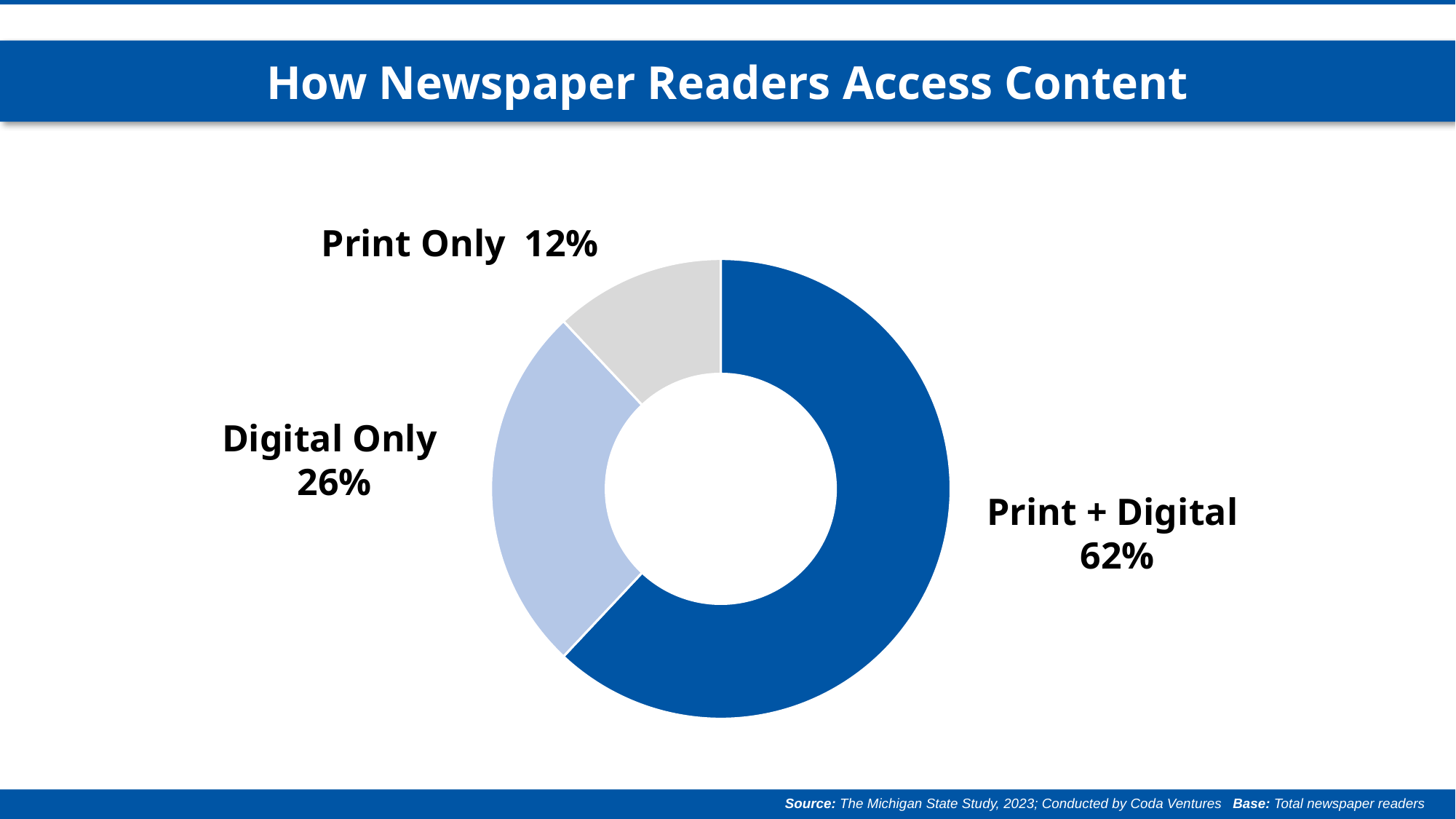
What percentage of newspaper readers access content via Print + Digital? 62% How many categories are shown in the chart? 3 What is the difference in percentage points between Digital Only and Print Only? 14 Which category has the largest share of newspaper readers? Print + Digital Which category has the smallest share of newspaper readers? Print Only What is the difference in percentage points between Print + Digital and Digital Only? 36 What percentage of newspaper readers are Print Only? 12% What colour is the Print Only slice of the chart? Light grey What is the title of the chart on the slide? How Newspaper Readers Access Content What percentage of newspaper readers are Digital Only? 26% What kind of chart is shown on the slide? Doughnut (pie) chart Which is larger, the Digital Only share or the Print Only share? Digital Only